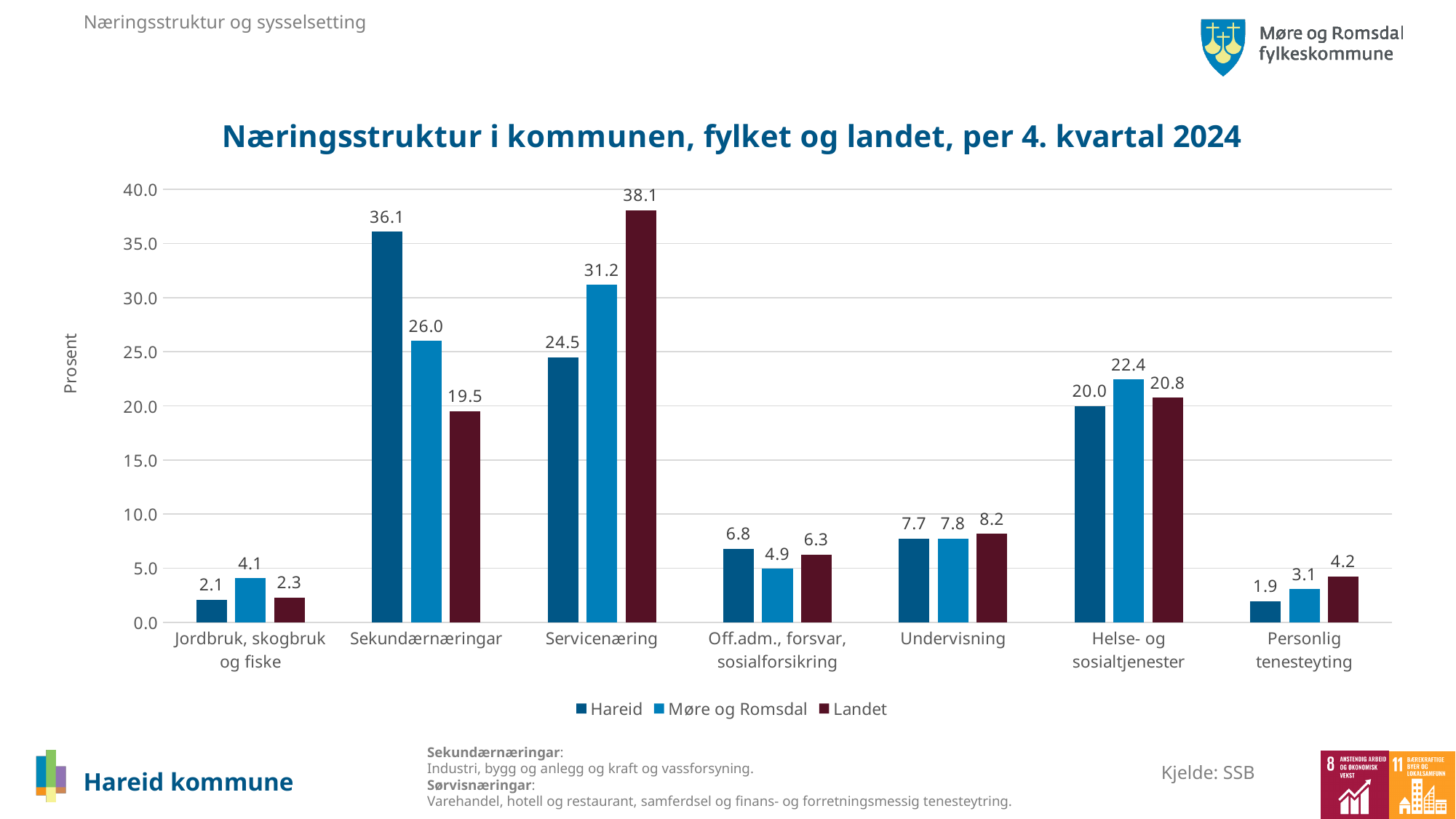
What is the difference between the Landet and Hareid values for Servicenæring? 13.6 Which is larger for Off.adm., forsvar, sosialforsikring: the Hareid value or the Møre og Romsdal value? Hareid What kind of chart is shown on the slide? Bar chart Which category has the highest value for Hareid? Sekundærnæringar How many categories are shown on the x axis? 7 What is the title of the chart? Næringsstruktur i kommunen, fylket og landet, per 4. kvartal 2024 What is the value for Møre og Romsdal in the Helse- og sosialtjenester category? 22.4 What is the value for Landet in the Servicenæring category? 38.1 How many series does the legend list? 3 What is the value for Hareid in the Sekundærnæringar category? 36.1 Is the value for Møre og Romsdal in Sekundærnæringar greater or less than 25.0? greater Which category has the lowest value for Landet? Jordbruk, skogbruk og fiske